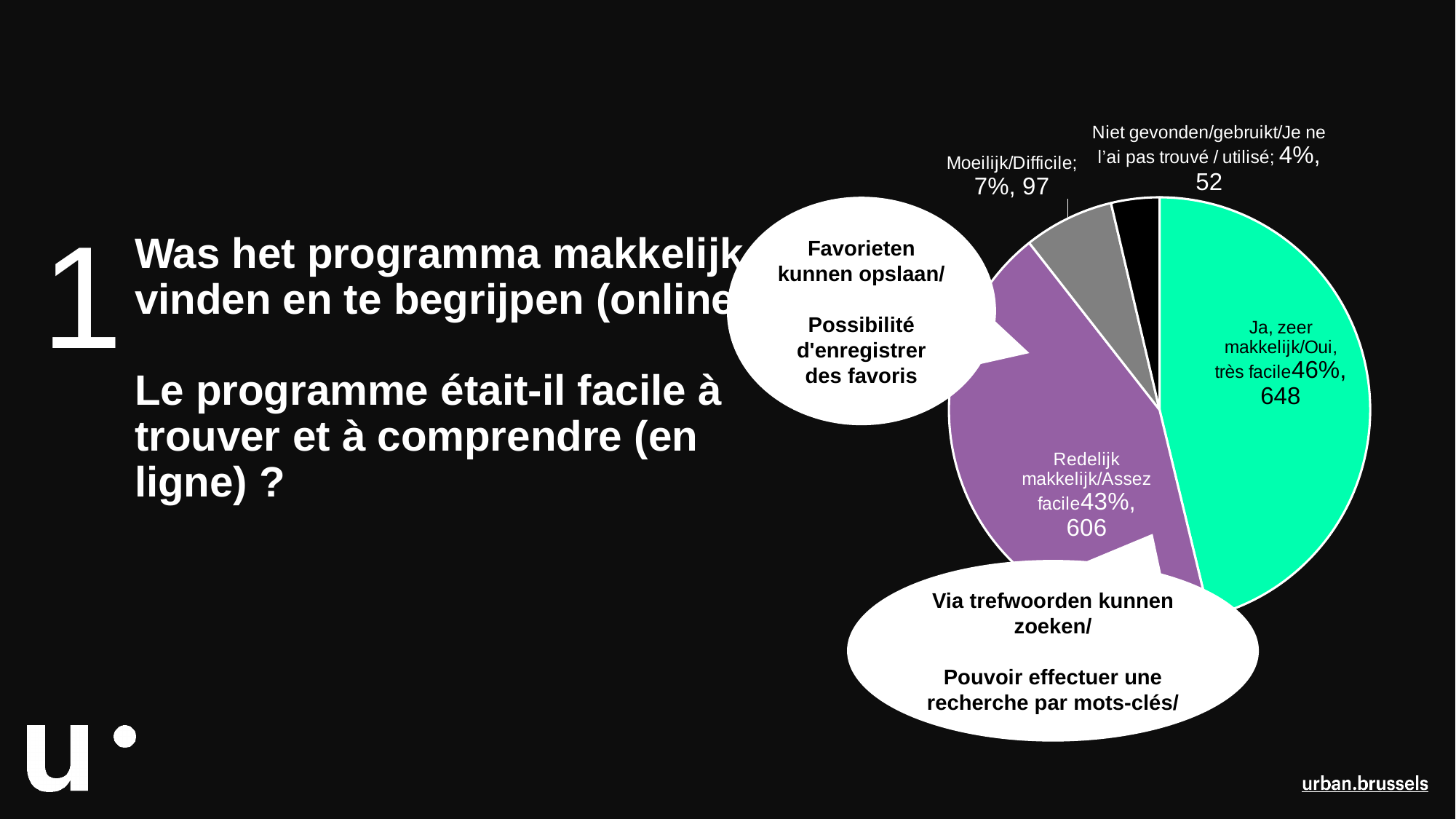
What count is shown for the 'Moeilijk/Difficile' slice? 97 Which is larger: the count for 'Moeilijk/Difficile' or the count for 'Niet gevonden/gebruikt/Je ne l'ai pas trouvé / utilisé'? Moeilijk/Difficile What count is shown for the 'Redelijk makkelijk/Assez facile' slice? 606 Which category has the smallest slice of the pie? Niet gevonden/gebruikt/Je ne l'ai pas trouvé / utilisé What kind of chart is shown on the slide? Pie chart What is the difference in count between 'Ja, zeer makkelijk/Oui, très facile' and 'Redelijk makkelijk/Assez facile'? 42 What is the total count across all four slices of the pie chart? 1403 Which category has the largest slice of the pie? Ja, zeer makkelijk/Oui, très facile How many slices does the pie chart have? 4 What percentage share does the 'Niet gevonden/gebruikt/Je ne l'ai pas trouvé / utilisé' slice have? 4% What percentage share does the 'Ja, zeer makkelijk/Oui, très facile' slice have? 46% What colour is the 'Redelijk makkelijk/Assez facile' slice? Purple